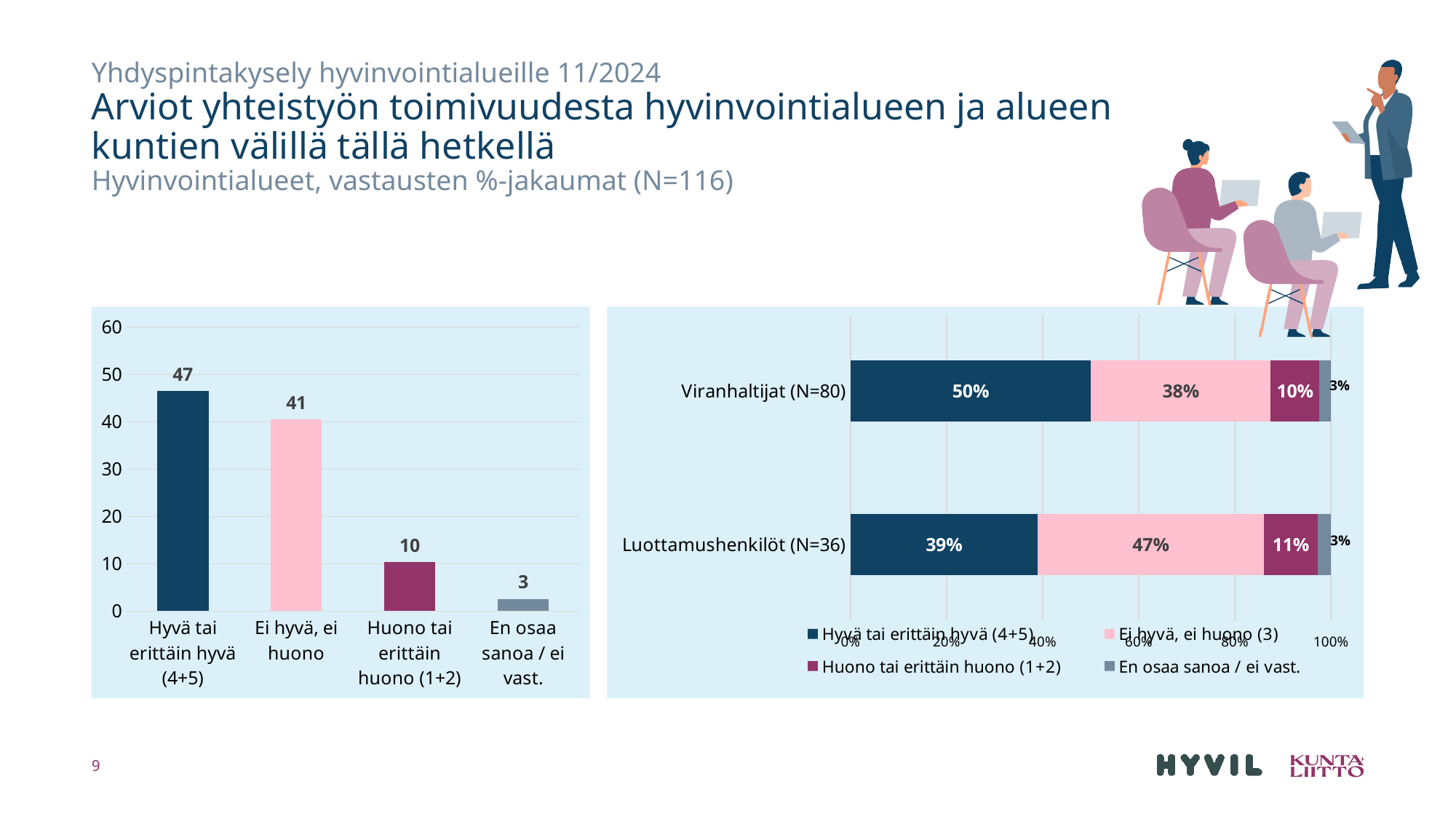
In the right chart, which group has the larger share of "Huono tai erittäin huono (1+2)": Viranhaltijat (N=80) or Luottamushenkilöt (N=36)? Luottamushenkilöt (N=36) In the left chart, which category has the highest value? Hyvä tai erittäin hyvä (4+5) How many series does the legend of the right chart list? 4 In the right chart, what is the share of "En osaa sanoa / ei vast." for Viranhaltijat (N=80)? 3% What kind of chart is the left chart? Bar chart In the left chart, what is the value for "Hyvä tai erittäin hyvä (4+5)"? 47 In the left chart, what is the difference between the values for "Hyvä tai erittäin hyvä (4+5)" and "Ei hyvä, ei huono"? 6 In the left chart, which category has the lowest value? En osaa sanoa / ei vast. In the left chart, how many categories are shown on the x axis? 4 In the right chart, what is the share of "Ei hyvä, ei huono (3)" for Luottamushenkilöt (N=36)? 47% In the right chart, what is the difference between the "Hyvä tai erittäin hyvä (4+5)" shares of Viranhaltijat (N=80) and Luottamushenkilöt (N=36)? 11 percentage points In the right chart, what is the share of "Hyvä tai erittäin hyvä (4+5)" for Viranhaltijat (N=80)? 50%